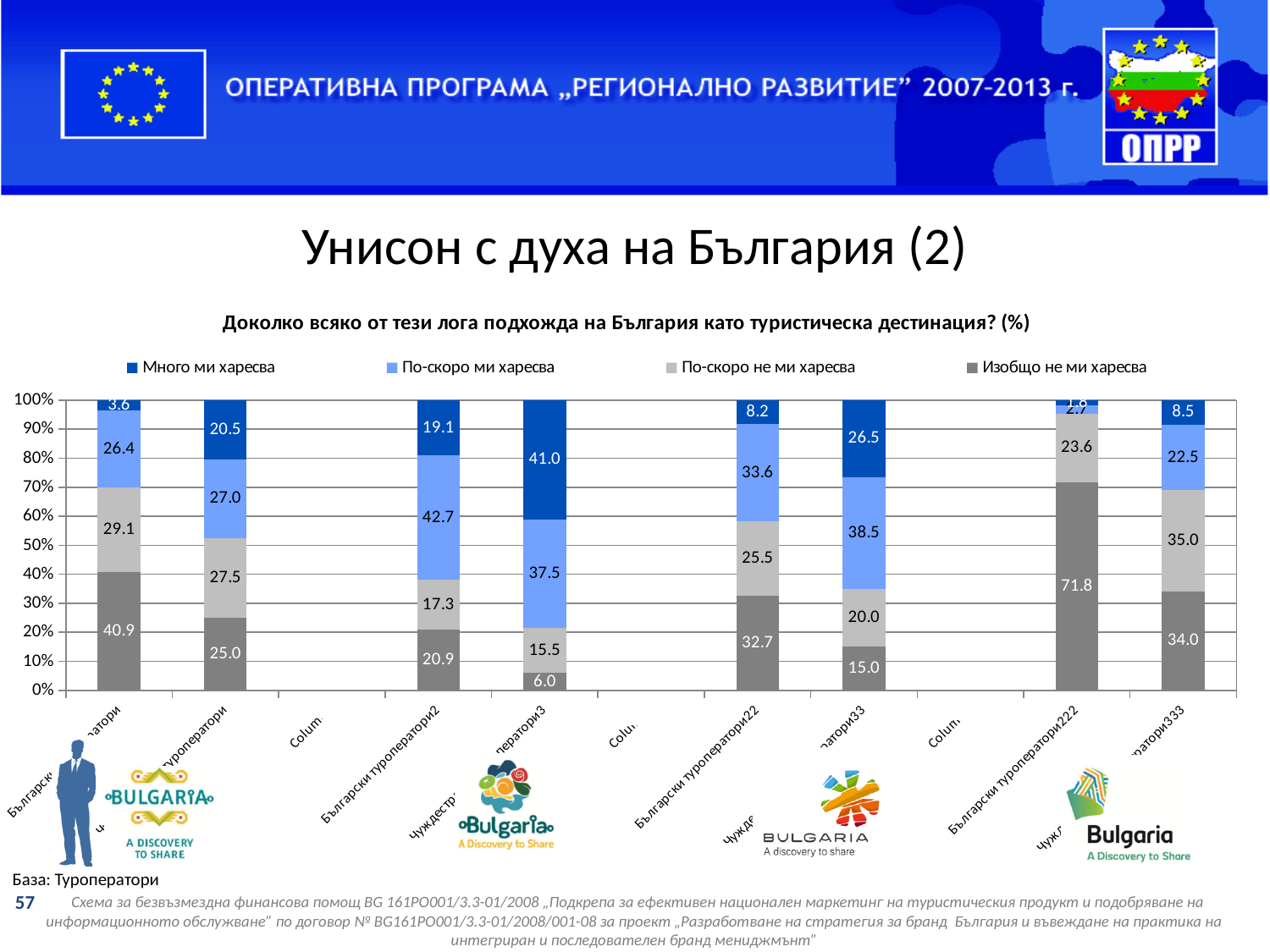
What kind of chart is shown on the slide? Stacked bar chart What is the title of the chart? Доколко всяко от тези лога подхожда на България като туристическа дестинация? (%) How many series does the chart legend list? 4 What is the highest value shown for "Много ми харесва" across all bars? 41.0 Which bar has the highest value for "Изобщо не ми харесва"? Български туроператори222 What is the lowest value shown for "Изобщо не ми харесва" across all bars? 6.0 What is the value of "По-скоро ми харесва" for "Български туроператори2"? 42.7 For "Български туроператори2", what is the difference between "По-скоро ми харесва" and "Много ми харесва"? 23.6 What is the value of "Изобщо не ми харесва" for "Български туроператори222"? 71.8 What is the value of "Изобщо не ми харесва" for the leftmost bar? 40.9 For "Български туроператори22", which is larger: "По-скоро не ми харесва" or "Изобщо не ми харесва"? Изобщо не ми харесва What is the value of "Много ми харесва" for "Български туроператори22"? 8.2